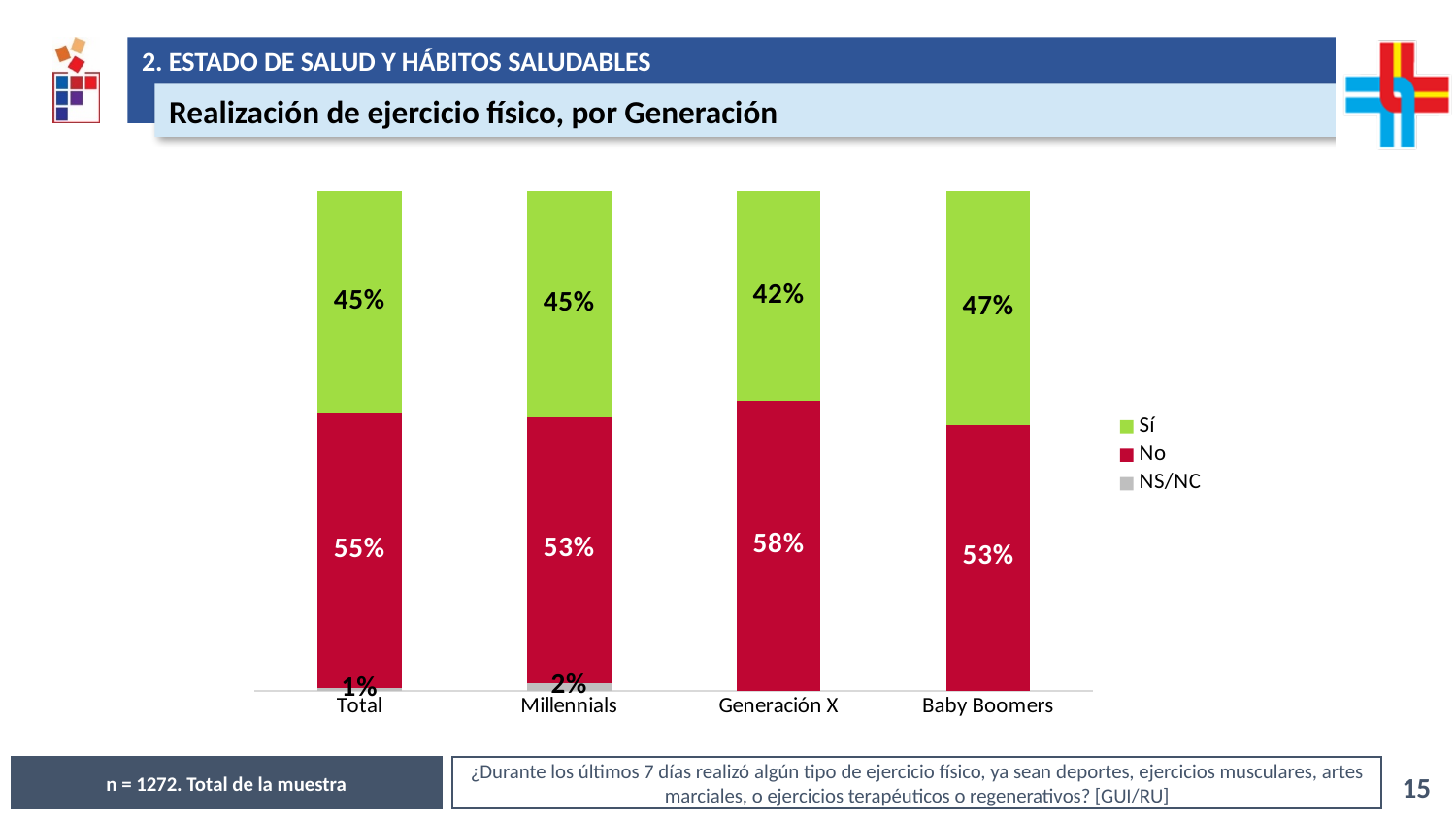
What kind of chart is shown on the slide? Stacked bar chart Which series is shown in green in the legend? Sí How many series does the legend list? 3 How many categories are shown on the x axis? 4 Which generation has the lowest "Sí" percentage? Generación X What is the difference between the "No" percentage for Generación X and for Millennials? 5% What is the "Sí" value for the Total category? 45% What is the "NS/NC" value for Millennials? 2% Which is larger: the "Sí" value for Baby Boomers or for Generación X? Baby Boomers What percentage of Generación X answered "No"? 58% What percentage of Baby Boomers answered "Sí"? 47% Which generation has the highest "No" percentage? Generación X